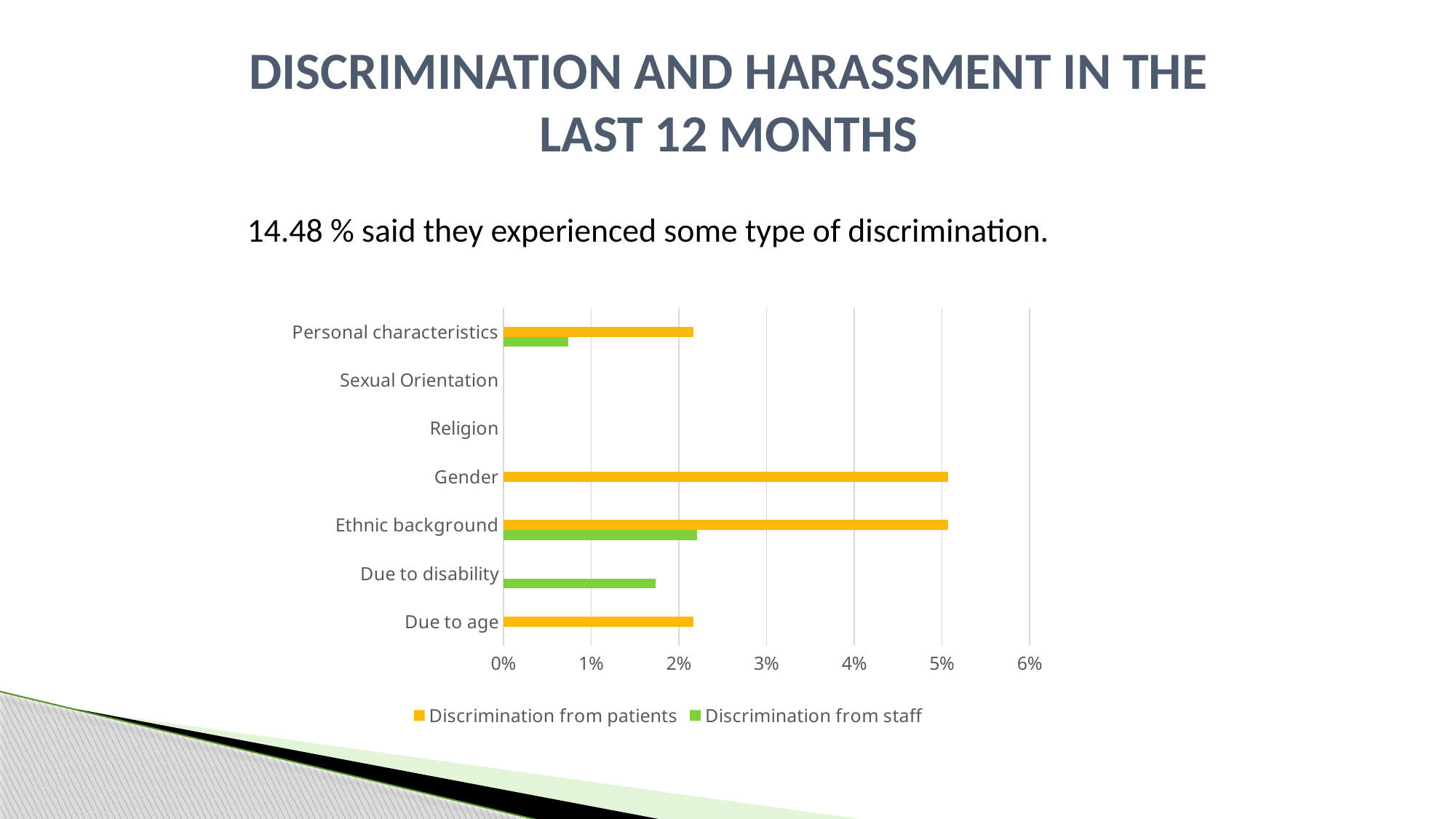
Is the value for Ethnic background in the Discrimination from staff series greater or less than 3%? less Is the value for Personal characteristics in the Discrimination from staff series greater or less than 1%? less In the Discrimination from staff series, which is larger: Due to disability or Personal characteristics? Due to disability Is the value for Due to disability in the Discrimination from staff series greater or less than 1%? greater How many categories are listed on the vertical axis of the chart? 7 Which category has the highest value in the Discrimination from staff series? Ethnic background Which series is shown in green in the chart? Discrimination from staff How many series does the chart legend list? 2 What kind of chart is shown on the slide? bar chart For Ethnic background, which series has the larger value: Discrimination from patients or Discrimination from staff? Discrimination from patients